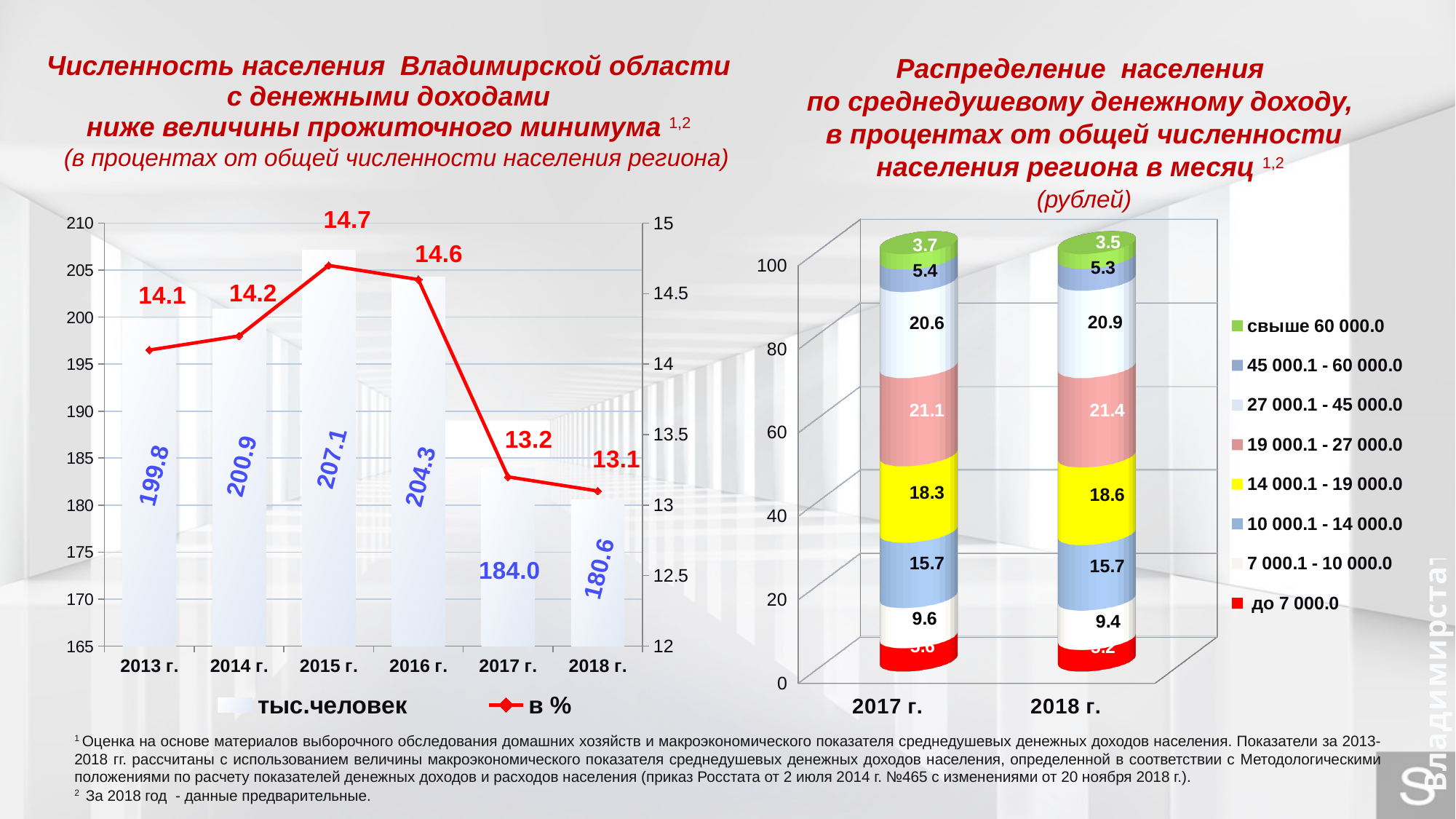
On the left chart, is the 'в %' value for 2014 г. larger or smaller than for 2016 г.? smaller On the left chart, how many years are shown on the x axis? 6 On the right chart, what is the value of the '14 000.1 - 19 000.0' segment for 2017 г.? 18.3 On the left chart, which year has the highest 'тыс.человек' bar? 2015 г. On the right chart, what is the value of the '27 000.1 - 45 000.0' segment for 2018 г.? 20.9 On the left chart, what is the 'в %' value for 2017 г.? 13.2 On the left chart, what is the difference between the 'тыс.человек' values for 2016 г. and 2017 г.? 20.3 On the left chart, which year has the lowest 'в %' value? 2018 г. On the left chart, what is the value of the 'тыс.человек' bar for 2015 г.? 207.1 On the left chart, how does the 'в %' line change from 2016 г. to 2018 г.? It falls What kind of chart is the right chart? Stacked bar chart On the right chart, how many income groups does the legend list? 8